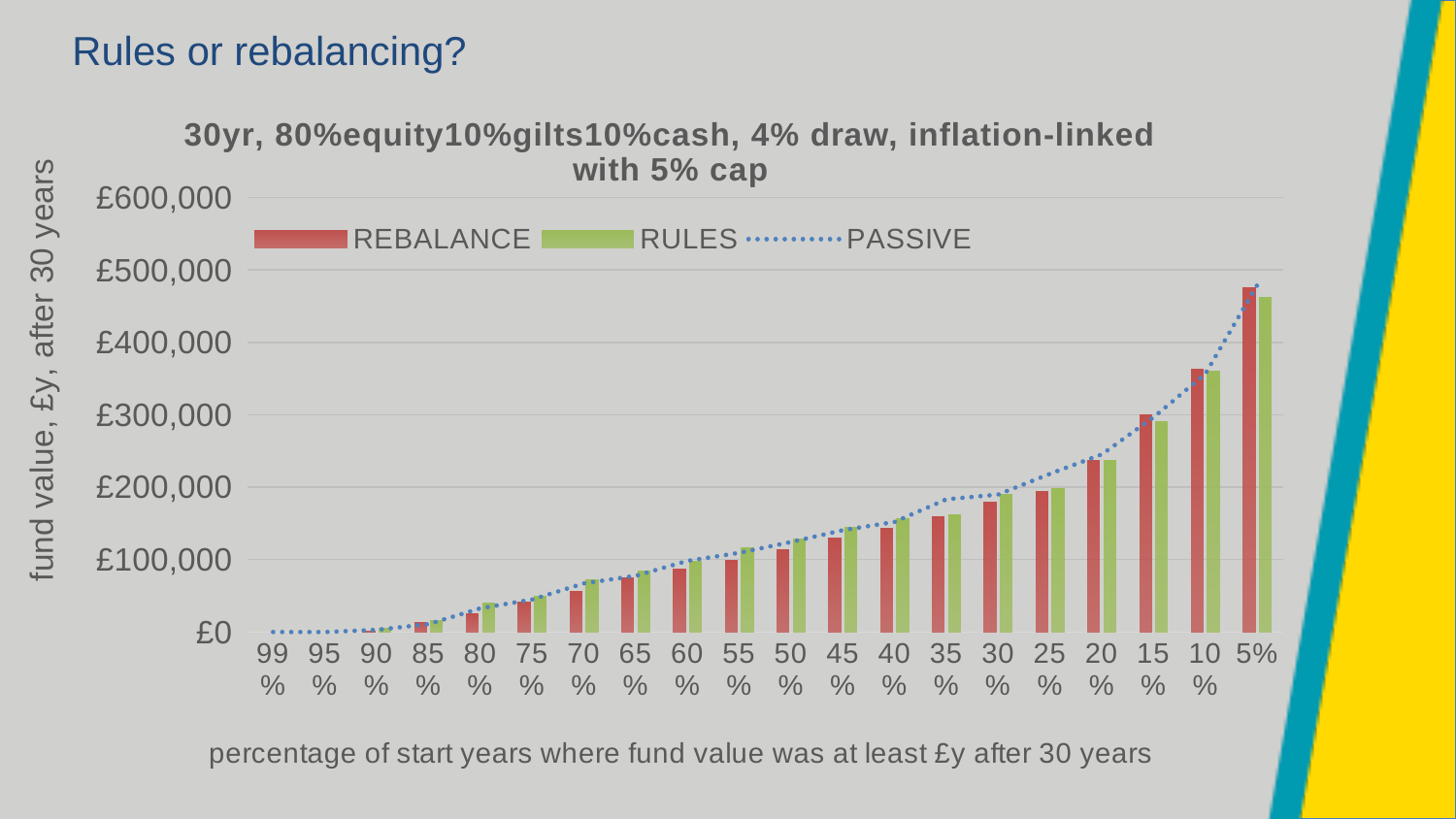
Which is larger: the REBALANCE value for 10% or the REBALANCE value for 20%? 10% What kind of chart is shown on the slide? Bar chart (with a dotted line series) How many categories are shown along the x axis? 20 Is the REBALANCE value for 20% greater or less than £200,000? greater Which series is shown as a dotted line in the legend? PASSIVE Is the RULES value for 10% greater or less than £300,000? greater Do the REBALANCE values rise or fall moving from left (99%) to right (5%) along the x axis? Rise How many series does the legend list? 3 Is the REBALANCE value for 5% greater or less than £400,000? greater Which category has the highest REBALANCE value? 5%